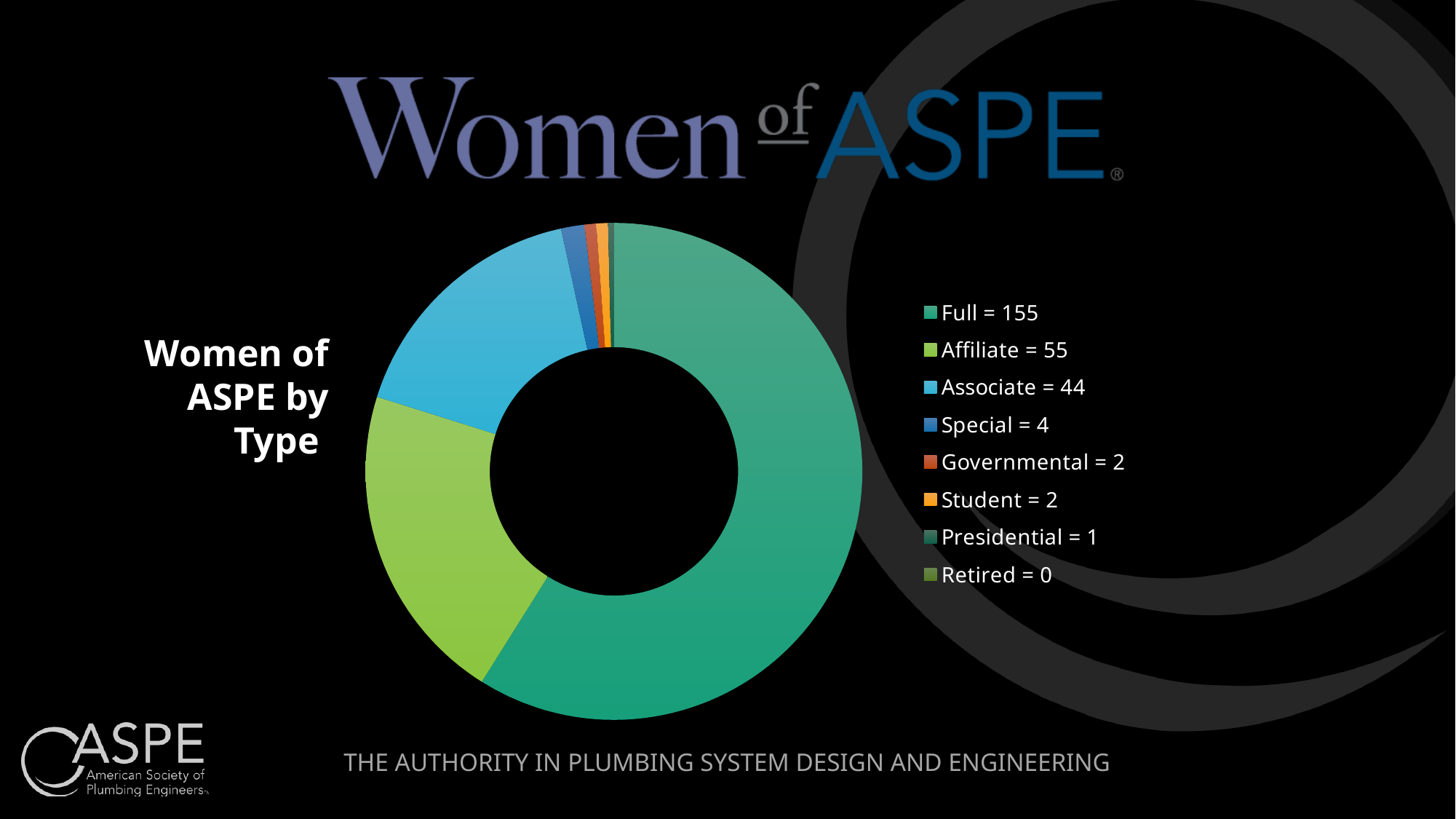
What kind of chart is used to show Women of ASPE by Type? Doughnut chart Which membership type has the lowest value in the Women of ASPE by Type chart? Retired What is the value for Special in the Women of ASPE by Type chart? 4 Which is larger in the Women of ASPE by Type chart, Associate or Special? Associate What is the difference between the Affiliate and Associate values in the Women of ASPE by Type chart? 11 What is the difference between the Full and Affiliate values in the Women of ASPE by Type chart? 100 What is the value for Affiliate in the Women of ASPE by Type chart? 55 What is the value for Full in the Women of ASPE by Type chart? 155 Which membership type has the highest value in the Women of ASPE by Type chart? Full What is the value for Associate in the Women of ASPE by Type chart? 44 What is the title of the chart on the slide? Women of ASPE by Type How many membership types are listed in the legend of the Women of ASPE by Type chart? 8